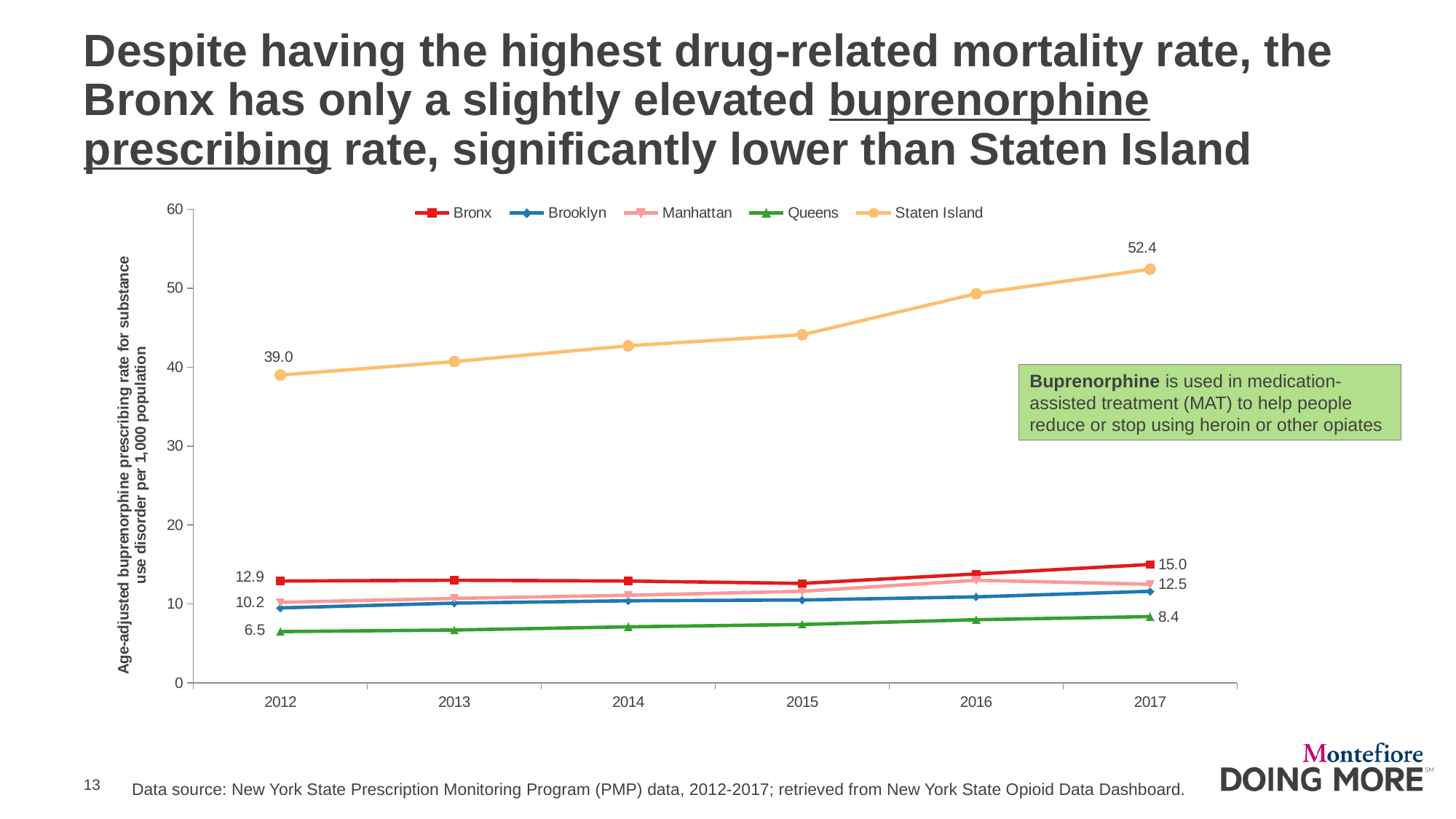
Does Staten Island's prescribing rate rise or fall from 2012 to 2017? Rise What type of chart is shown on the slide? Line chart By how much did Staten Island's prescribing rate increase from 2012 to 2017? 13.4 What is the buprenorphine prescribing rate for Staten Island in 2012? 39.0 What is the buprenorphine prescribing rate for Staten Island in 2017? 52.4 What is the difference between the Bronx's prescribing rate in 2017 and in 2012? 2.1 What is the buprenorphine prescribing rate for Queens in 2012? 6.5 How many series does the legend list? 5 How many years are shown on the x axis? 6 What is the buprenorphine prescribing rate for the Bronx in 2017? 15.0 Which borough has the lowest buprenorphine prescribing rate in 2017? Queens Which borough has the highest buprenorphine prescribing rate in 2017? Staten Island